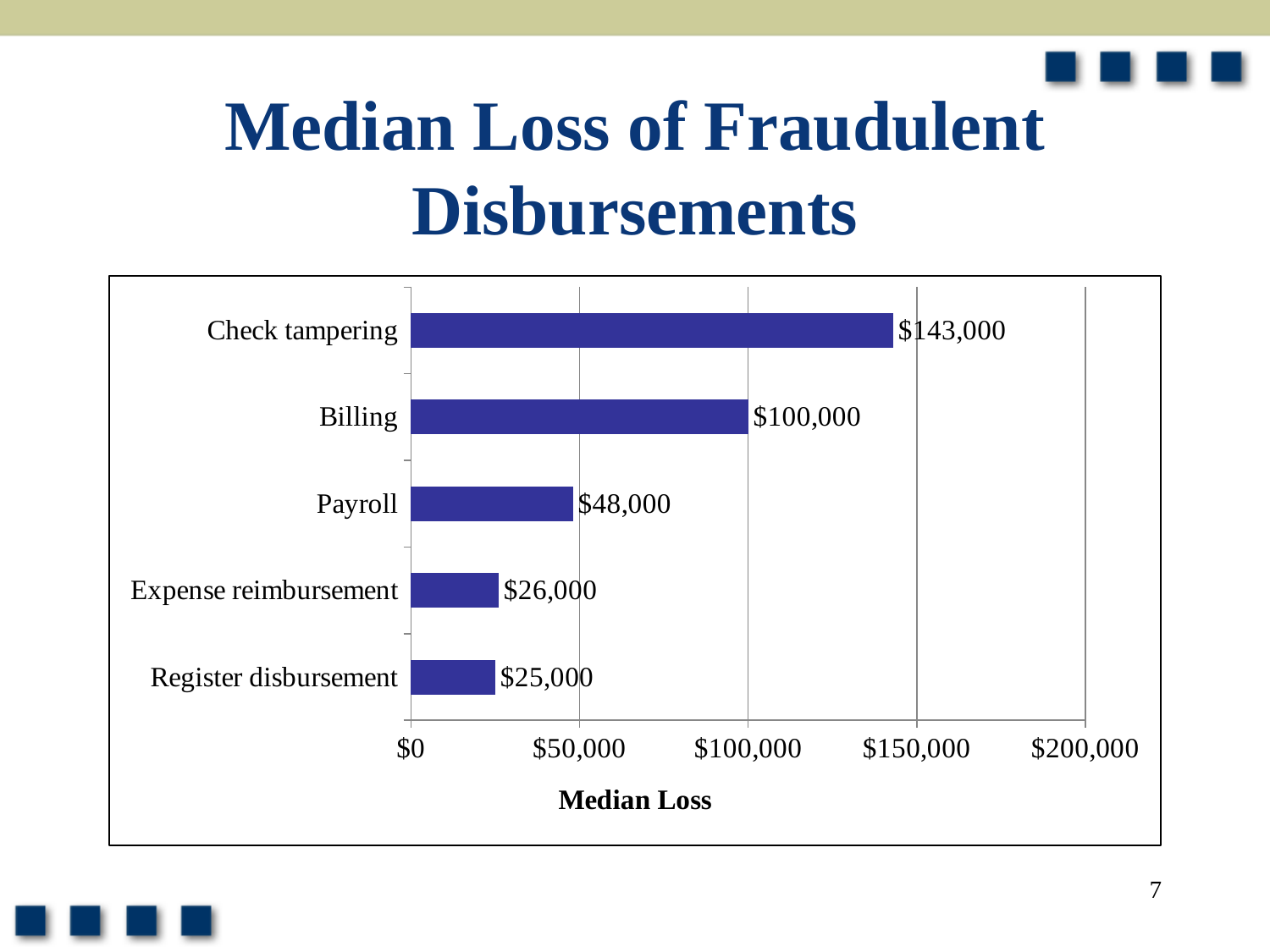
Which has a larger median loss, Payroll or Billing? Billing Which category has the highest median loss? Check tampering What is the difference in median loss between Check tampering and Billing? $43,000 What is the median loss for Billing? $100,000 What is the label on the horizontal axis of the chart? Median Loss What is the median loss for Expense reimbursement? $26,000 Which category has the lowest median loss? Register disbursement How many categories are shown in the chart? 5 What is the median loss for Payroll? $48,000 What kind of chart is shown on the slide? Bar chart What is the median loss for Register disbursement? $25,000 What is the median loss for Check tampering? $143,000